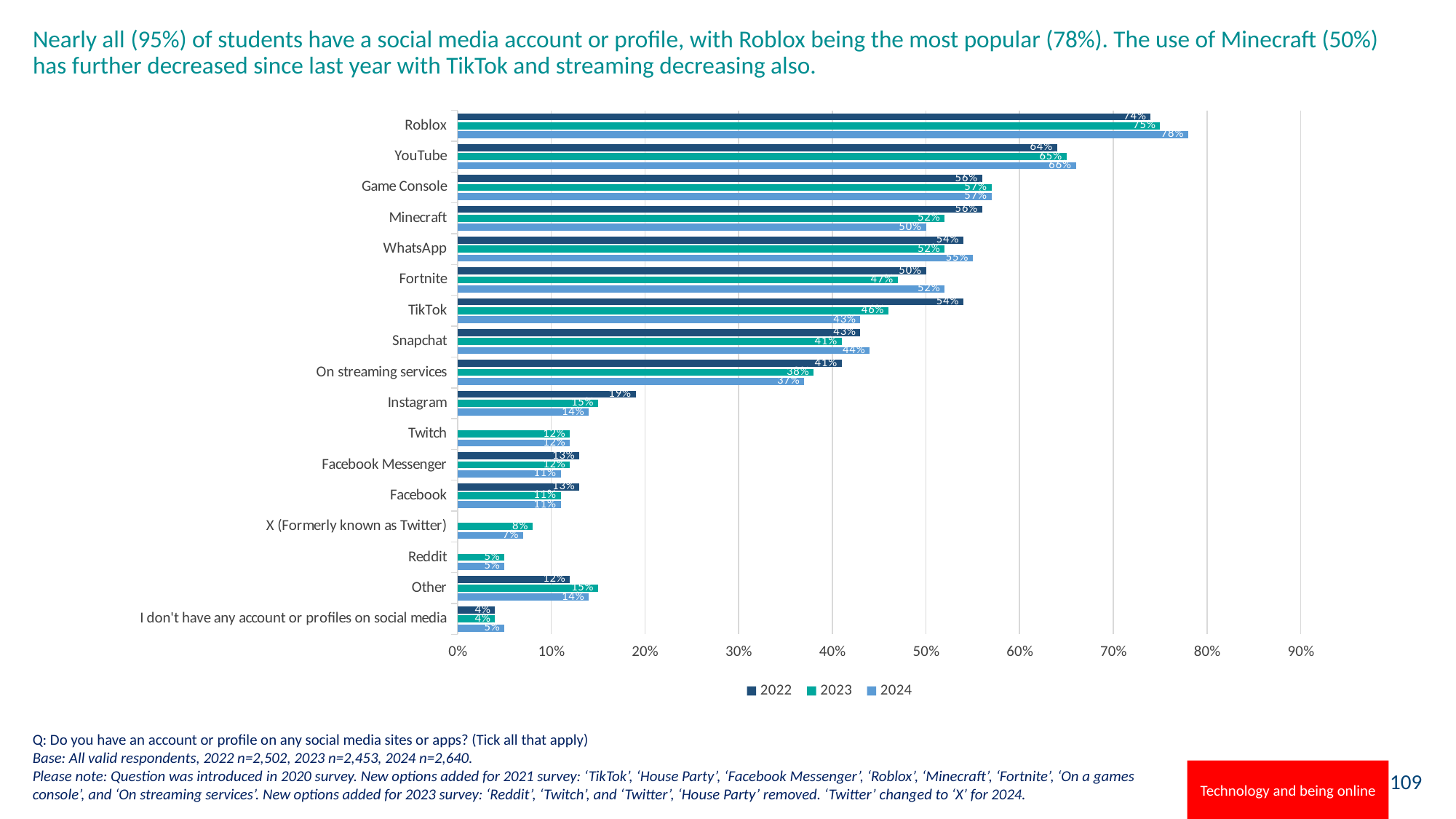
Which platform has the highest 2024 value? Roblox Which category has the lowest 2022 value? I don't have any account or profiles on social media What was the value for TikTok in 2022? 54% Is the 2024 value for YouTube greater or less than 60%? greater By how many percentage points did TikTok fall from 2022 to 2024? 11 percentage points How many series does the legend list? 3 Did the value for Roblox rise or fall from 2022 to 2024? Rise How many categories are listed on the vertical axis of the chart? 17 What percentage of students had a Roblox account in 2024? 78% Which had a higher 2024 value, Fortnite or WhatsApp? WhatsApp What is the 2024 value for Minecraft? 50% What kind of chart is shown on the slide? Bar chart